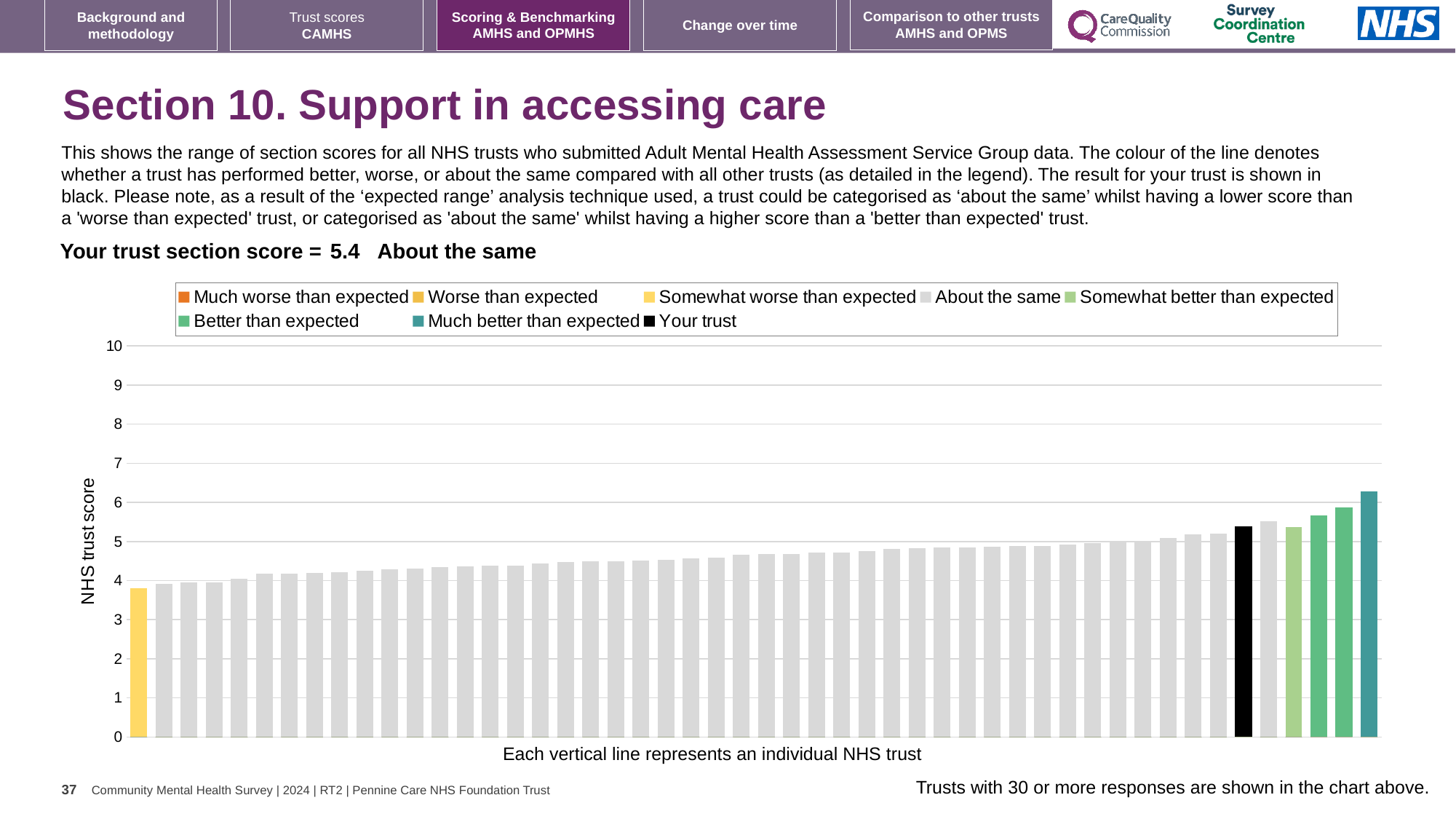
Is your trust's section score greater or less than 5? greater Is your trust's bar taller or shorter than the rightmost (teal) bar? shorter How many entries does the chart legend list? 8 Is the value of the tallest bar (the rightmost bar) greater or less than 6? greater Which legend category does the tallest bar belong to? Much better than expected What kind of chart is shown on the slide? bar chart According to the x-axis label, what does each vertical line represent? an individual NHS trust Do the bar values rise or fall from left to right along the x axis? rise What is your trust's section score for Support in accessing care? 5.4 What colour is the bar representing your trust? black Is your trust's section score greater or less than 6? less